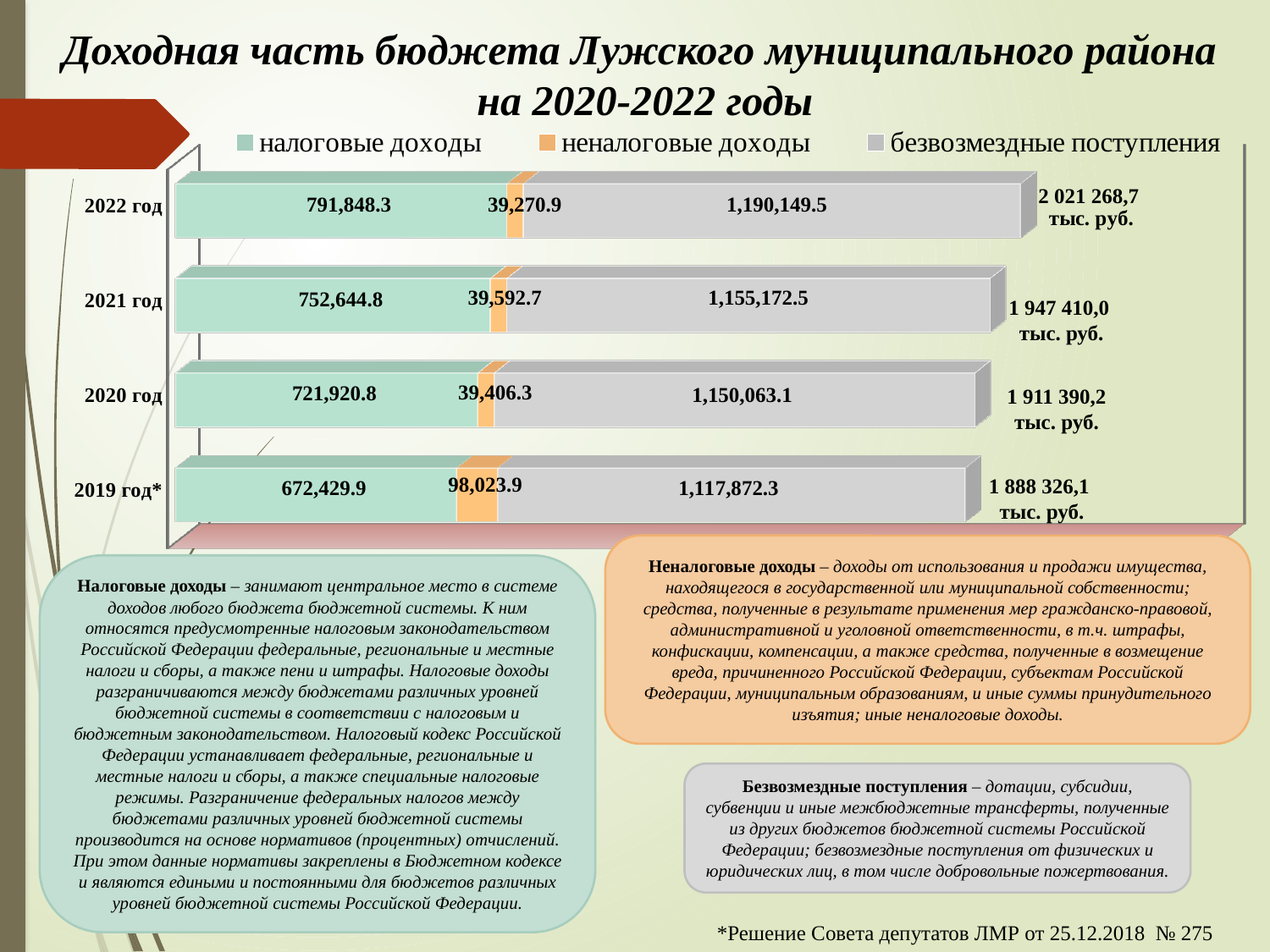
Which is larger: неналоговые доходы in 2021 год or in 2020 год? 2021 год Which year has the lowest value of налоговые доходы? 2019 год* How many years (categories) are shown in the chart? 4 What is the value of неналоговые доходы for 2019 год*? 98,023.9 Do налоговые доходы increase or decrease from 2019 год* to 2022 год? increase How many series does the legend list? 3 Which year has the highest value of неналоговые доходы? 2019 год* What is the difference between налоговые доходы in 2022 год and in 2019 год*? 119,418.4 What is the value of безвозмездные поступления for 2020 год? 1,150,063.1 What is the total of the stacked bar for 2022 год? 2 021 268,7 тыс. руб. What is the value of налоговые доходы for 2022 год? 791,848.3 What is the difference between безвозмездные поступления in 2022 год and in 2021 год? 34,977.0